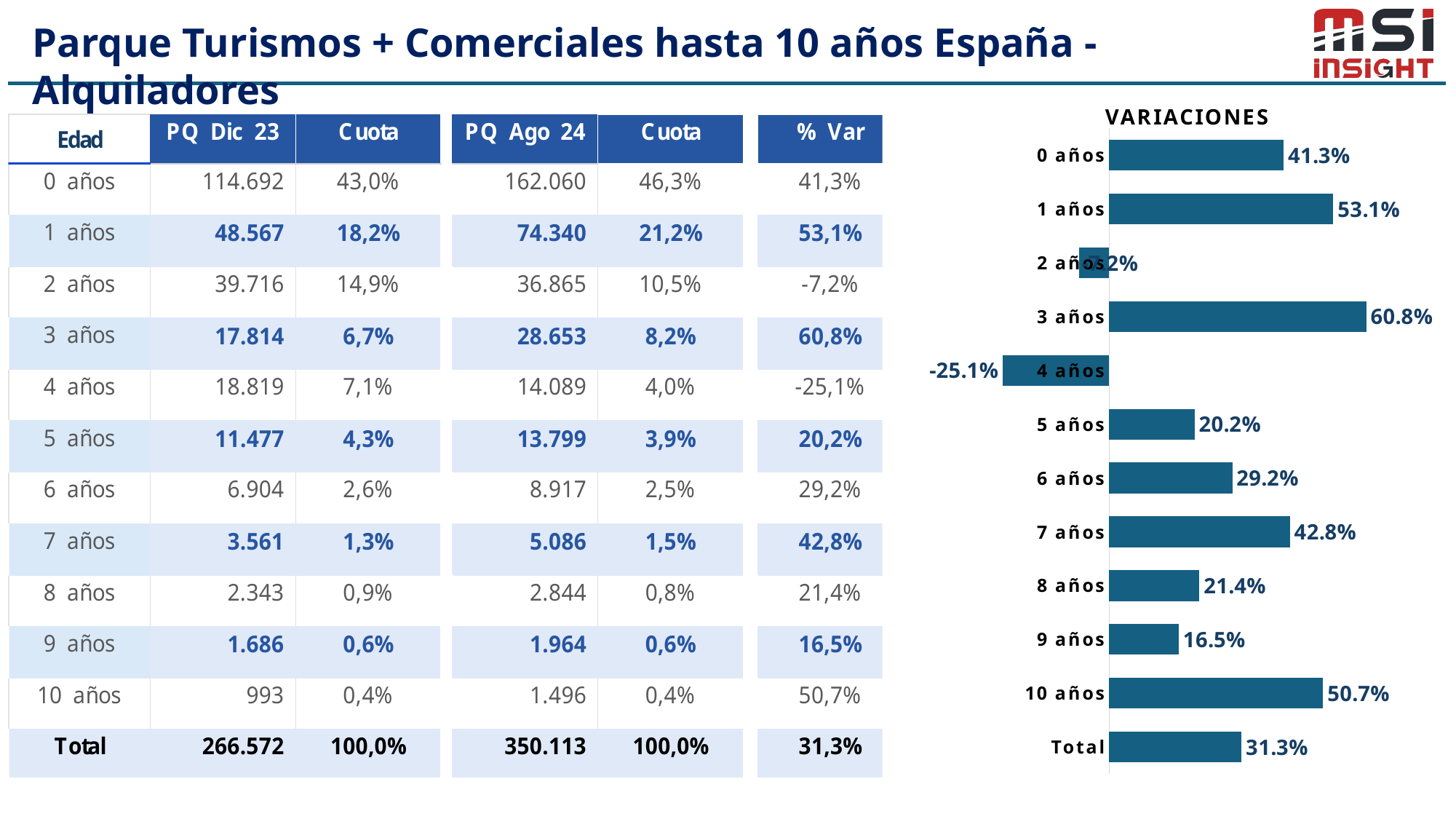
What is the title of the chart on the right of the slide? VARIACIONES What kind of chart is the VARIACIONES chart? Bar chart In the VARIACIONES chart, which is larger, the value for 5 años or the value for 6 años? 6 años In the VARIACIONES chart, which category has the highest value? 3 años In the VARIACIONES chart, what is the value for Total? 31.3% In the VARIACIONES chart, what is the value for 10 años? 50.7% How many bars are plotted in the VARIACIONES chart? 12 In the VARIACIONES chart, which category has the lowest value? 4 años In the VARIACIONES chart, what is the value for 3 años? 60.8% In the VARIACIONES chart, what is the difference between the values for 3 años and 1 años? 7.7 percentage points In the VARIACIONES chart, what is the value for 0 años? 41.3% In the VARIACIONES chart, which is larger, the value for 7 años or the value for 0 años? 7 años